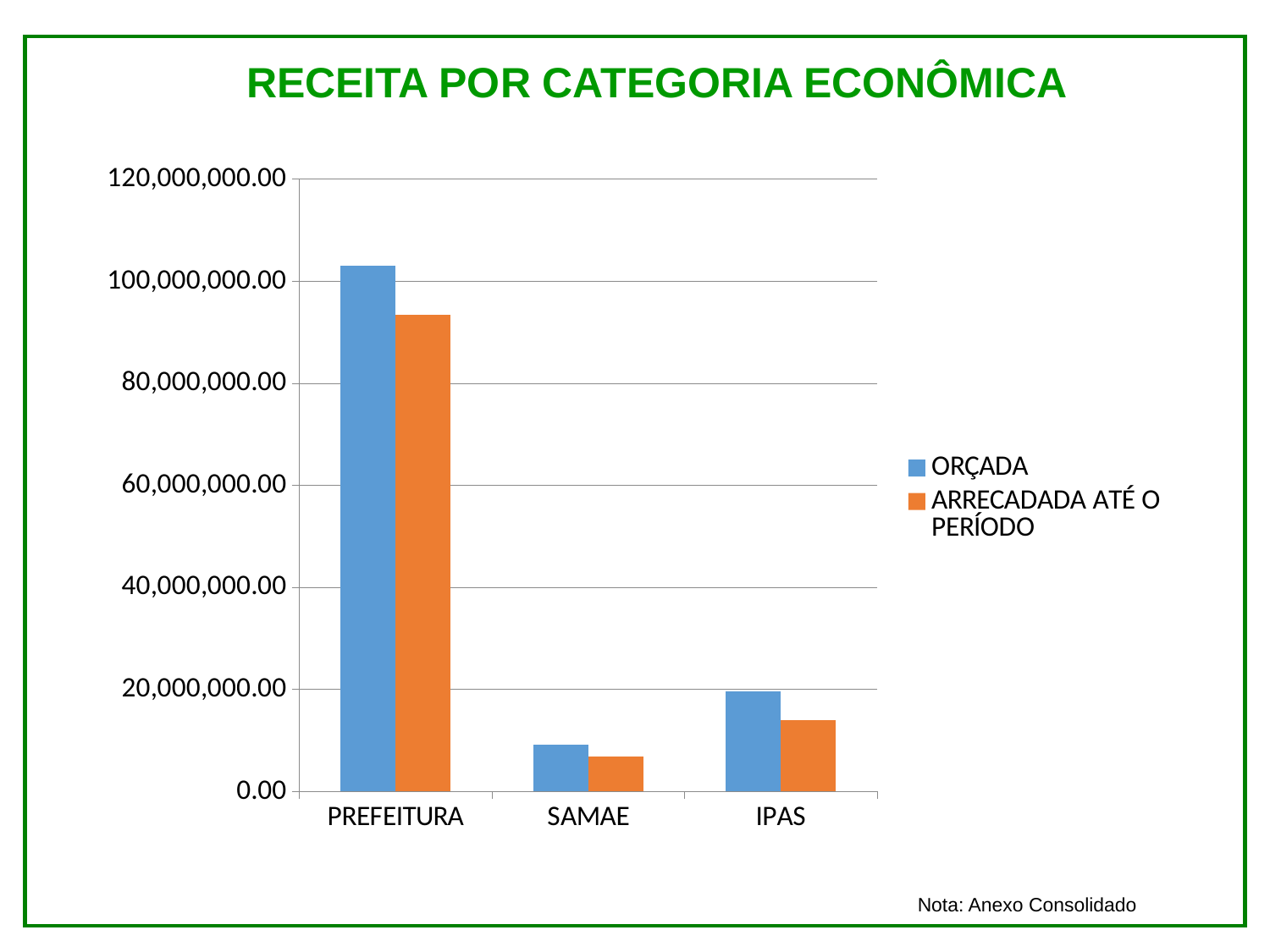
How many series does the legend list? 2 How many categories are shown on the x axis? 3 Is the ORÇADA value for PREFEITURA greater or less than 80,000,000.00? greater Is the ORÇADA value for SAMAE greater or less than 20,000,000.00? less For IPAS, which is larger, ORÇADA or ARRECADADA ATÉ O PERÍODO? ORÇADA What is the title of the chart? RECEITA POR CATEGORIA ECONÔMICA What kind of chart is shown on the slide? bar chart Which category has the lowest ARRECADADA ATÉ O PERÍODO value? SAMAE Which category has the highest ORÇADA value? PREFEITURA Is the ARRECADADA ATÉ O PERÍODO value for IPAS greater or less than 20,000,000.00? less Which is larger, the ORÇADA value for SAMAE or the ORÇADA value for IPAS? IPAS